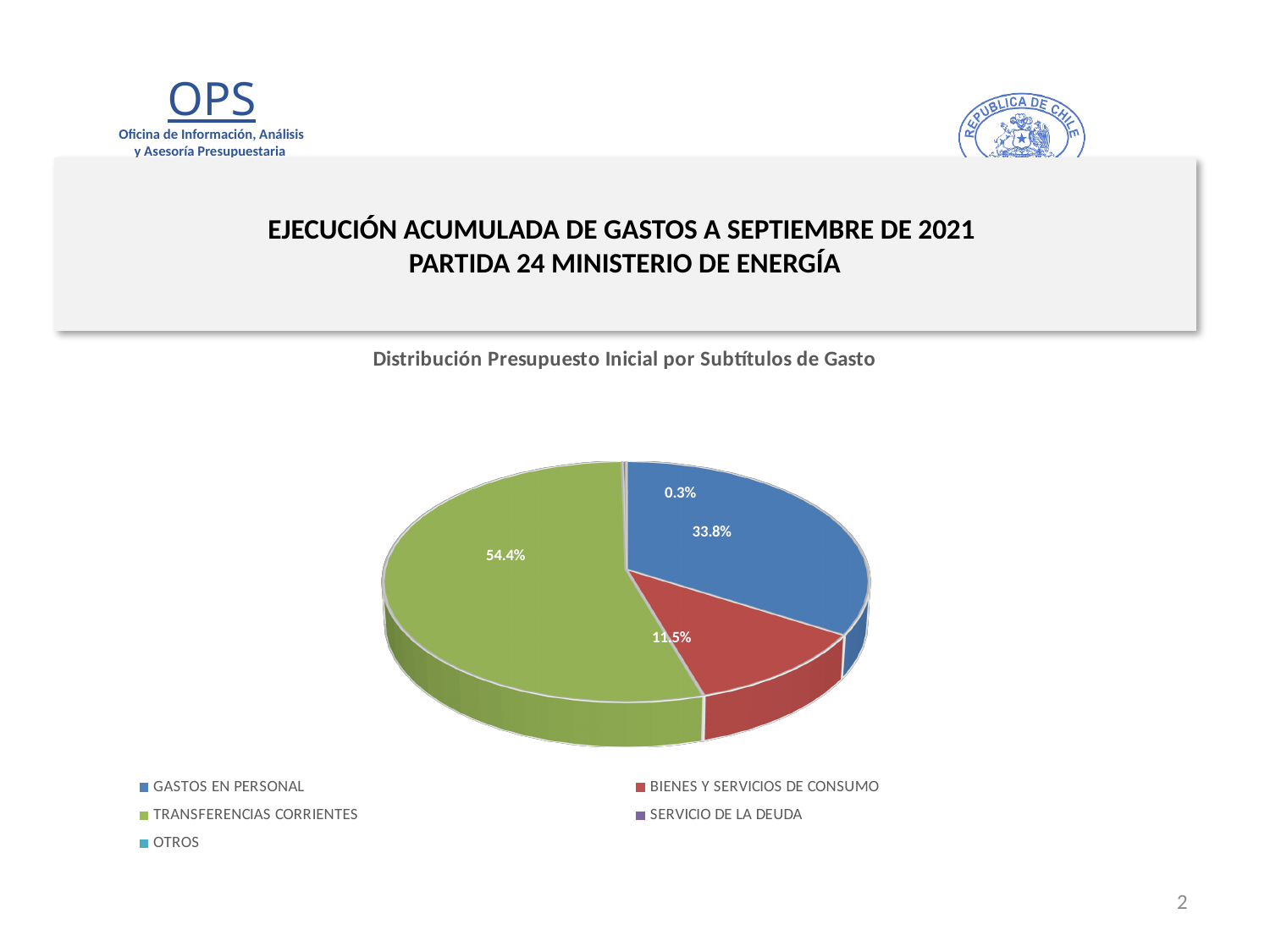
What percentage of the pie does GASTOS EN PERSONAL represent? 33.8% Which has a larger share, GASTOS EN PERSONAL or BIENES Y SERVICIOS DE CONSUMO? GASTOS EN PERSONAL What percentage of the pie does TRANSFERENCIAS CORRIENTES represent? 54.4% What is the smallest percentage label shown on the pie? 0.3% How many entries does the legend list? 5 Which category has the largest share of the pie? TRANSFERENCIAS CORRIENTES How many percentage points larger is the share of GASTOS EN PERSONAL than that of BIENES Y SERVICIOS DE CONSUMO? 22.3 percentage points What kind of chart is shown on the slide? Pie chart What colour is the TRANSFERENCIAS CORRIENTES slice? Green What percentage of the pie does BIENES Y SERVICIOS DE CONSUMO represent? 11.5% How many percentage points larger is the share of TRANSFERENCIAS CORRIENTES than that of GASTOS EN PERSONAL? 20.6 percentage points What is the title of the chart? Distribución Presupuesto Inicial por Subtítulos de Gasto